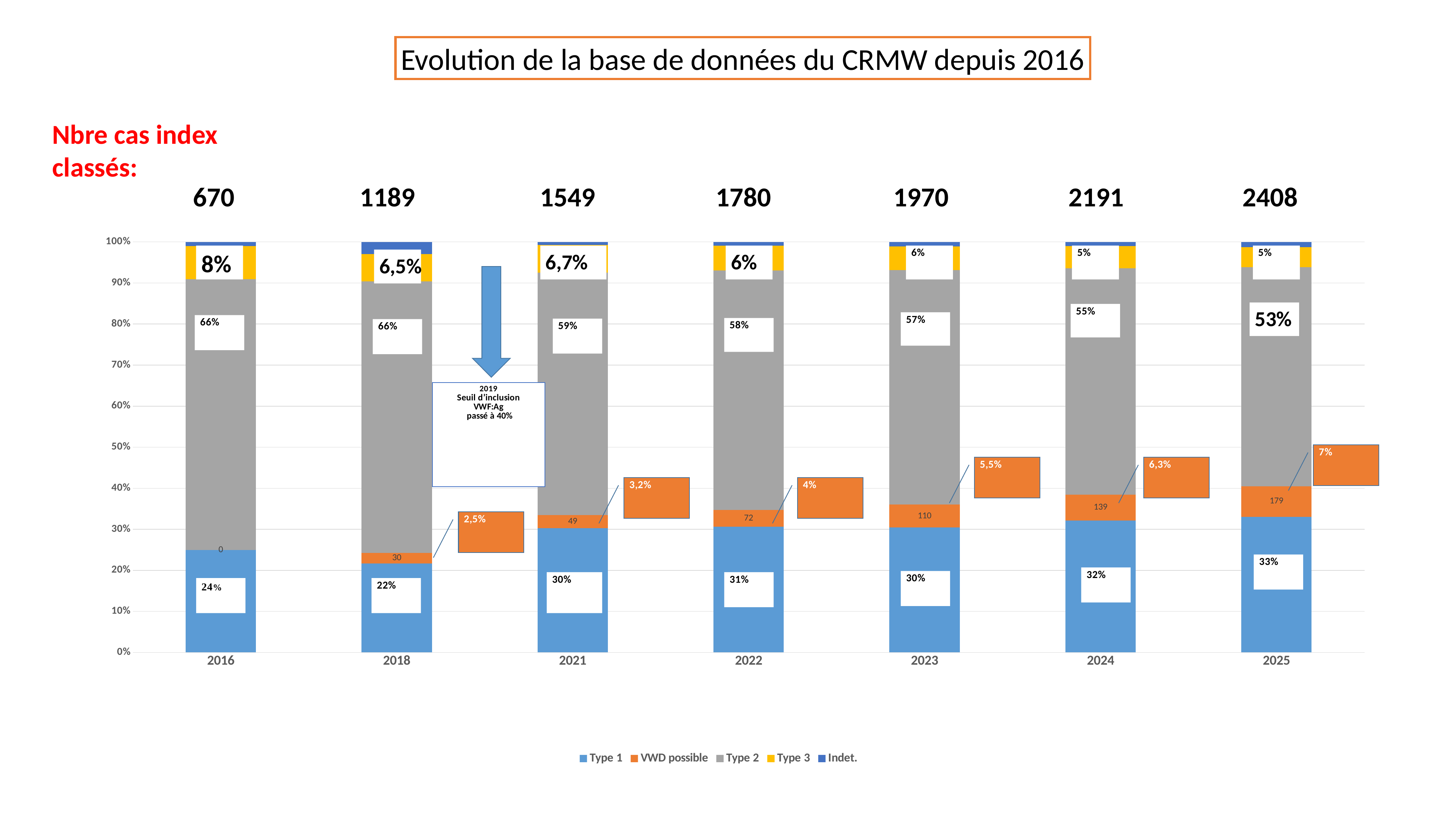
What is the difference between the Type 2 percentage in 2016 and in 2025? 13% What is the Type 2 percentage for 2021? 59% What is the Type 3 percentage for 2018? 6,5% Which year has the lowest Type 1 percentage? 2018 How many series does the legend list? 5 How many years are shown on the x axis of the chart? 7 What kind of chart is shown on the slide? stacked bar chart Is the Type 1 percentage larger in 2024 or in 2022? 2024 Does the Type 2 percentage rise or fall from 2016 to 2025? fall What is the Type 1 percentage for 2025? 33% What is the VWD possible count labelled for 2023? 110